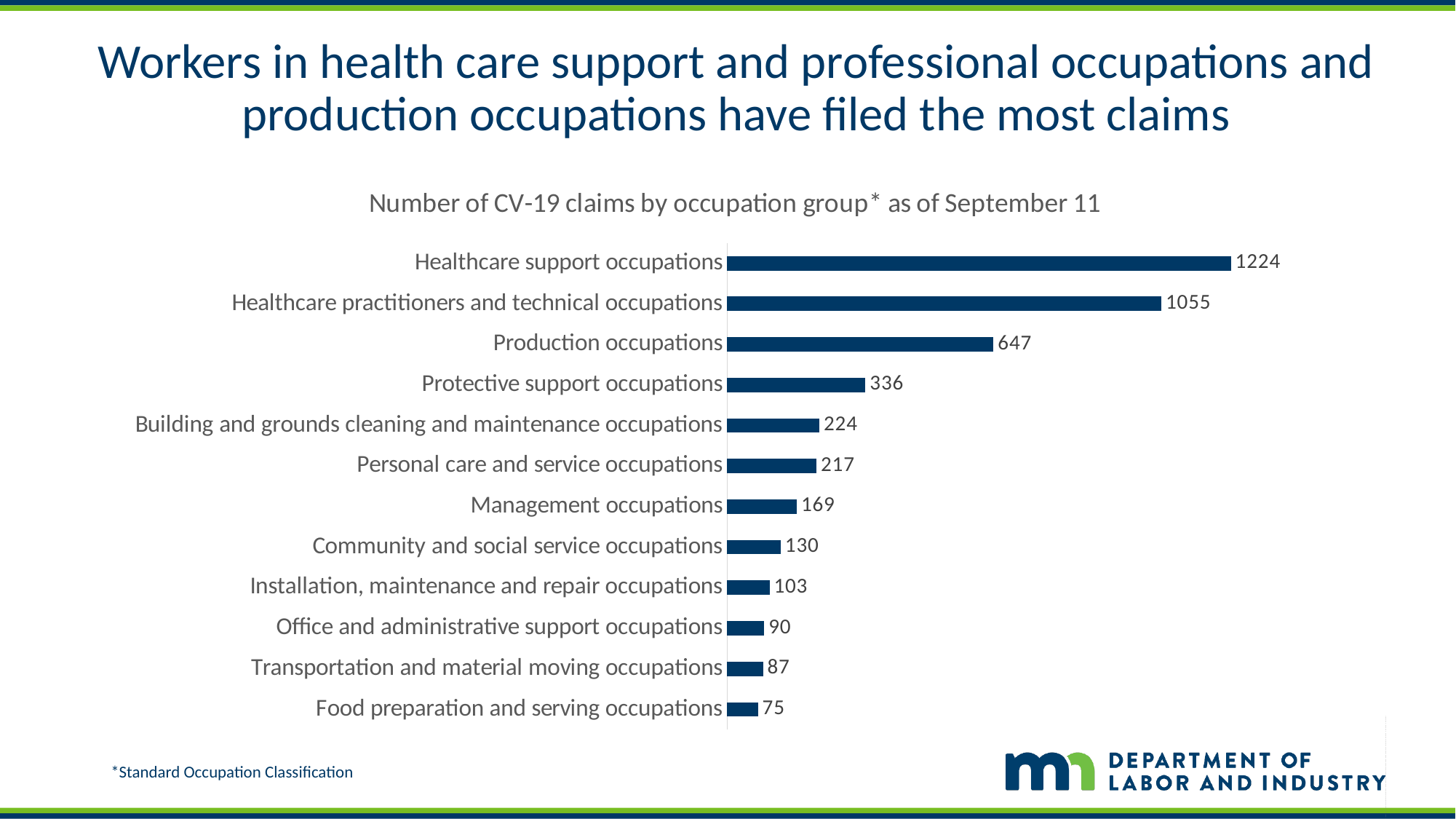
What is the number of claims for production occupations? 647 How many claims were filed by workers in management occupations? 169 What is the difference in claims between protective support occupations and production occupations? 311 Which has more claims: office and administrative support occupations or community and social service occupations? Community and social service occupations How many CV-19 claims were filed by workers in healthcare support occupations? 1224 What is the difference in claims between healthcare support occupations and healthcare practitioners and technical occupations? 169 How many occupation groups are shown in the chart? 12 What type of chart is shown on the slide? Bar chart Which has more claims: building and grounds cleaning and maintenance occupations or personal care and service occupations? Building and grounds cleaning and maintenance occupations Which occupation group has the lowest number of claims? Food preparation and serving occupations Which occupation group has the highest number of claims? Healthcare support occupations What is the title of the chart? Number of CV-19 claims by occupation group* as of September 11